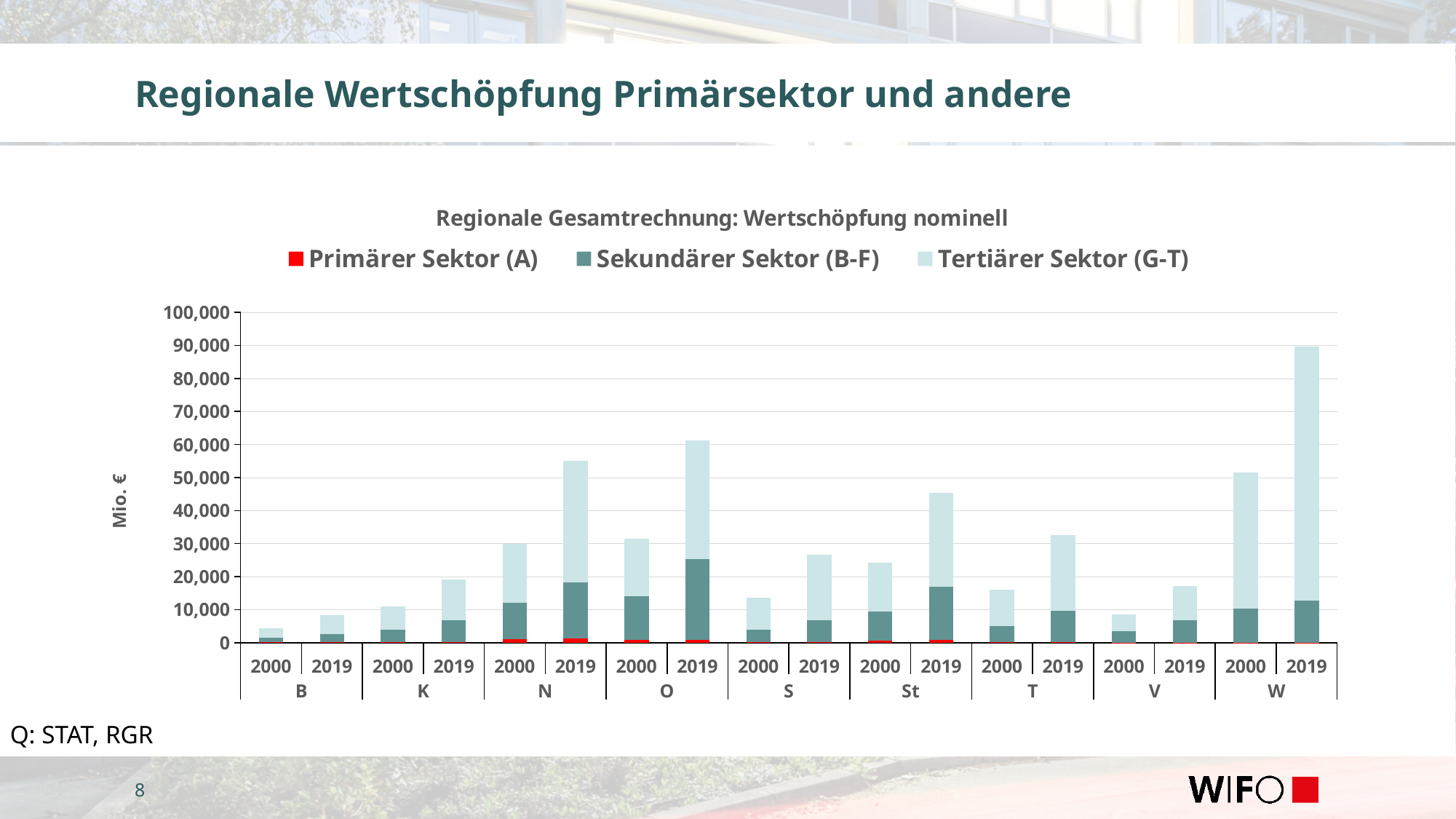
Is the total value for B in 2000 greater or less than 10,000? less What kind of chart is shown on the slide? stacked bar chart Which has the larger total value: O in 2019 or W in 2019? W in 2019 What is the title of the chart? Regionale Gesamtrechnung: Wertschöpfung nominell Which region and year has the highest total value? W 2019 Which region and year has the lowest total value? B 2000 For each region, is the total value in 2019 higher or lower than in 2000? higher Is the total value for W in 2019 greater or less than 80,000? greater Is the total value for N in 2019 greater or less than 50,000? greater How many series does the legend list? 3 How many regions are shown along the x axis? 9